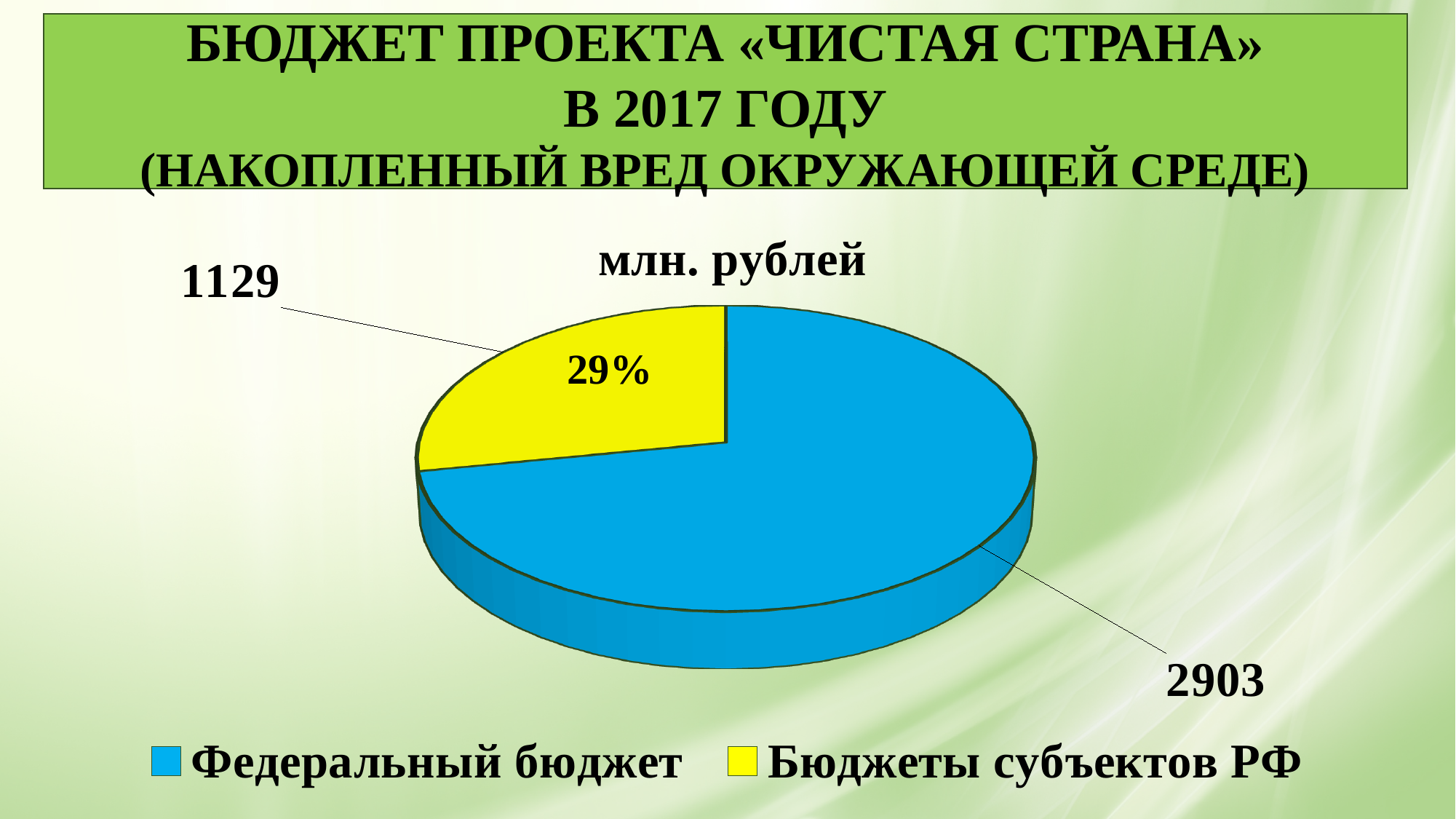
What share of the pie does Бюджеты субъектов РФ represent, as printed on the slide? 29% Which is larger, the value for Федеральный бюджет or the value for Бюджеты субъектов РФ? Федеральный бюджет What is the value for Бюджеты субъектов РФ? 1129 What unit is given in the chart title above the pie? млн. рублей Which category has the largest slice of the pie? Федеральный бюджет Which category has the smallest slice of the pie? Бюджеты субъектов РФ How many slices does the pie chart have? 2 What is the total of the two values shown in the pie chart? 4032 What is the value for Федеральный бюджет? 2903 What is the difference between the value for Федеральный бюджет and the value for Бюджеты субъектов РФ? 1774 What kind of chart is shown on the slide? pie chart How many entries does the legend list? 2